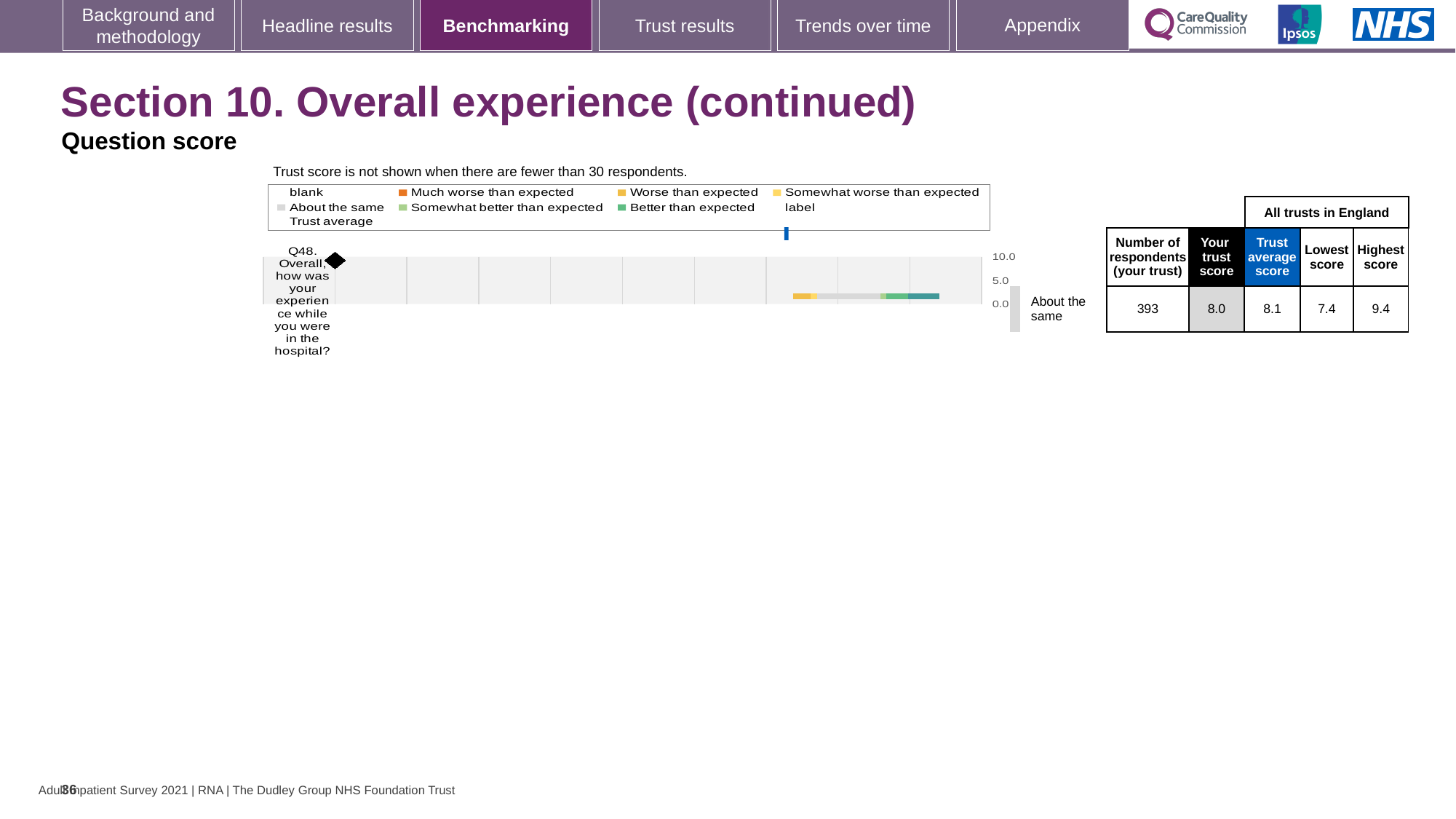
What is the lowest score for Q48 among all trusts in England? 7.4 What is the difference between the trust average score and your trust score for Q48? 0.1 What is the 'Your trust score' for Q48, overall experience while in hospital? 8.0 What kind of chart is used to show the Q48 benchmarking result? bar chart What is the difference between the highest score and the lowest score for Q48? 2.0 Which is larger for Q48: your trust score or the trust average score? Trust average score How many questions are plotted on the benchmarking chart? 1 What is the highest score for Q48 among all trusts in England? 9.4 What benchmark category label is shown next to the Q48 bar? About the same How many respondents from your trust answered Q48? 393 Is your trust score for Q48 greater or less than 5.0? greater What is the trust average score for Q48 across all trusts in England? 8.1